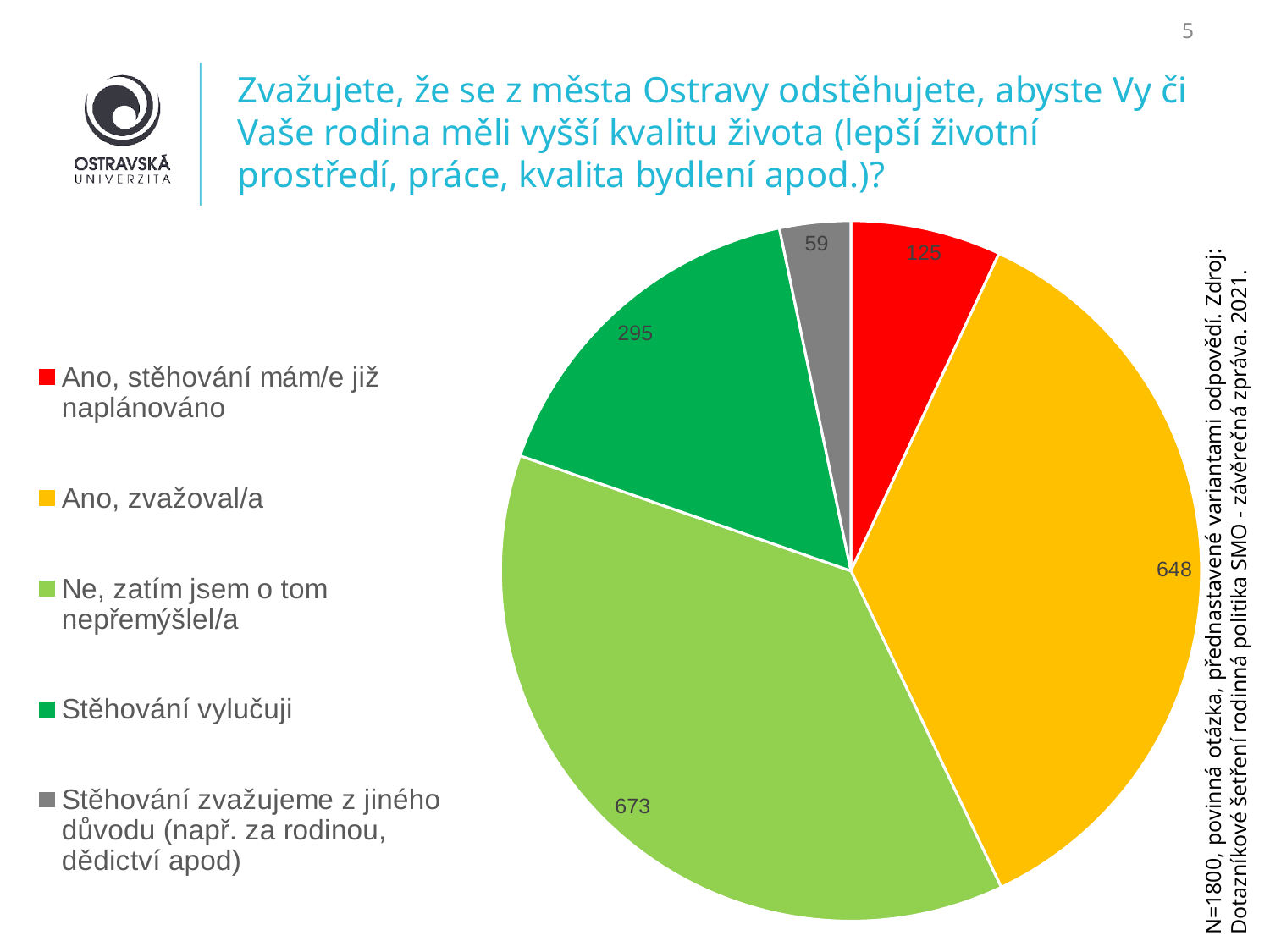
Which category has the smallest slice? Stěhování zvažujeme z jiného důvodu (např. za rodinou, dědictví apod) What is the value for "Ne, zatím jsem o tom nepřemýšlel/a"? 673 What is the value for "Ano, stěhování mám/e již naplánováno"? 125 What is the value for "Stěhování vylučuji"? 295 Which is larger, the value for "Stěhování vylučuji" or the value for "Ano, stěhování mám/e již naplánováno"? Stěhování vylučuji Which category has the largest slice? Ne, zatím jsem o tom nepřemýšlel/a What type of chart is shown on the slide? pie chart What is the value for "Ano, zvažoval/a"? 648 How many slices does the pie chart have? 5 What is the difference between the values for "Ne, zatím jsem o tom nepřemýšlel/a" and "Ano, zvažoval/a"? 25 What is the value for "Stěhování zvažujeme z jiného důvodu (např. za rodinou, dědictví apod)"? 59 What share of the pie does "Ano, zvažoval/a" represent? 36%